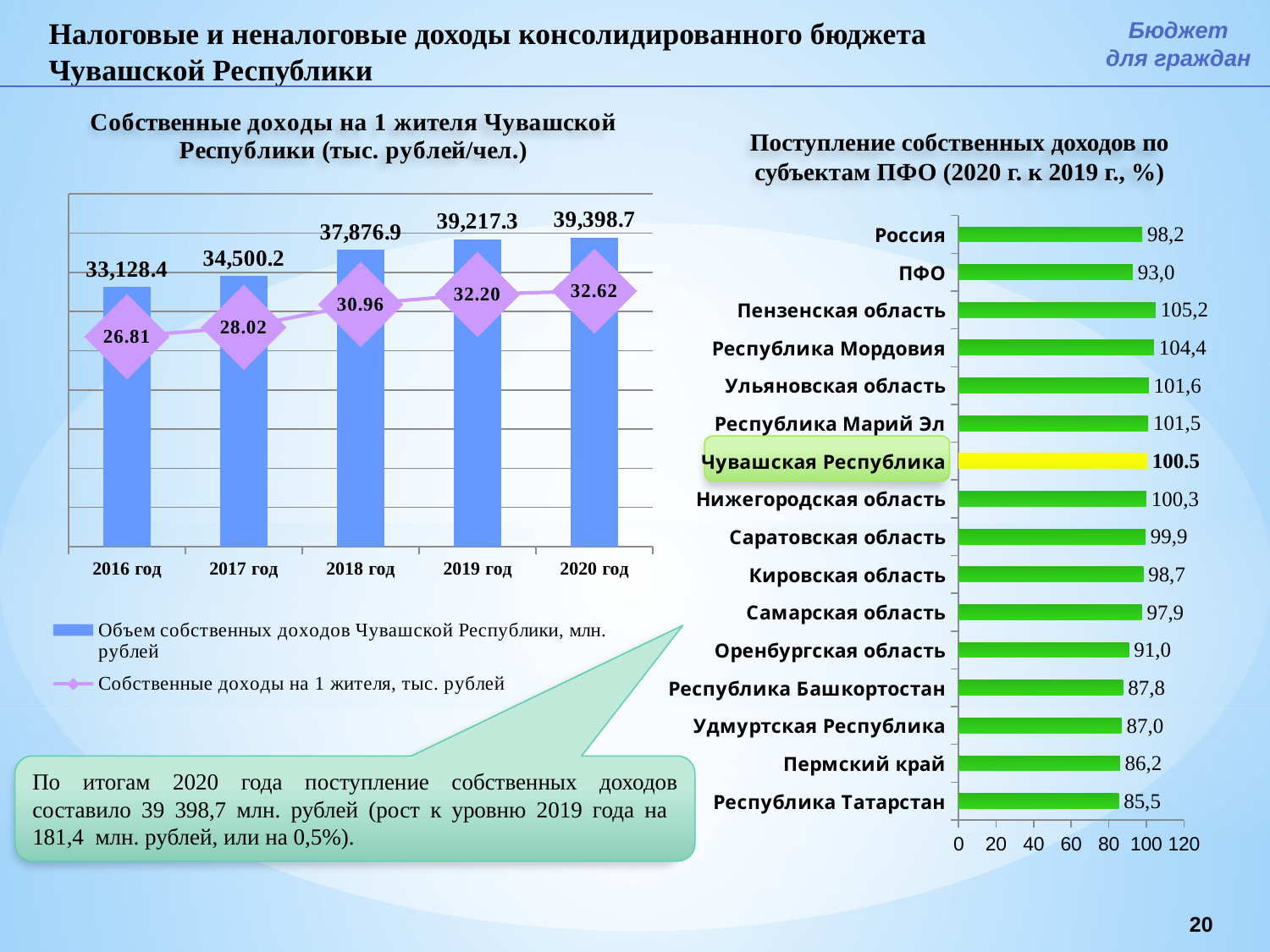
In the left chart 'Собственные доходы на 1 жителя Чувашской Республики', how many series does the legend list? 2 In the left chart 'Собственные доходы на 1 жителя Чувашской Республики', do the bar values rise or fall from 2016 год to 2020 год? rise In the right chart 'Поступление собственных доходов по субъектам ПФО', which region has the highest value? Пензенская область In the right chart 'Поступление собственных доходов по субъектам ПФО', which is larger: the value for Россия or the value for ПФО? Россия In the right chart 'Поступление собственных доходов по субъектам ПФО', what is the difference between the values for Республика Мордовия and Удмуртская Республика? 17,4 In the left chart 'Собственные доходы на 1 жителя Чувашской Республики', what is the difference between the bar values for 2020 год and 2019 год? 181.4 In the left chart 'Собственные доходы на 1 жителя Чувашской Республики', what is the value of the bar for 2020 год? 39,398.7 What kind of chart is the right chart 'Поступление собственных доходов по субъектам ПФО'? bar chart In the left chart 'Собственные доходы на 1 жителя Чувашской Республики', how many years are shown on the x axis? 5 In the left chart 'Собственные доходы на 1 жителя Чувашской Республики', what is the value of the line point for 2016 год? 26.81 In the right chart 'Поступление собственных доходов по субъектам ПФО', what is the value for Чувашская Республика? 100.5 In the right chart 'Поступление собственных доходов по субъектам ПФО', which region has the lowest value? Республика Татарстан